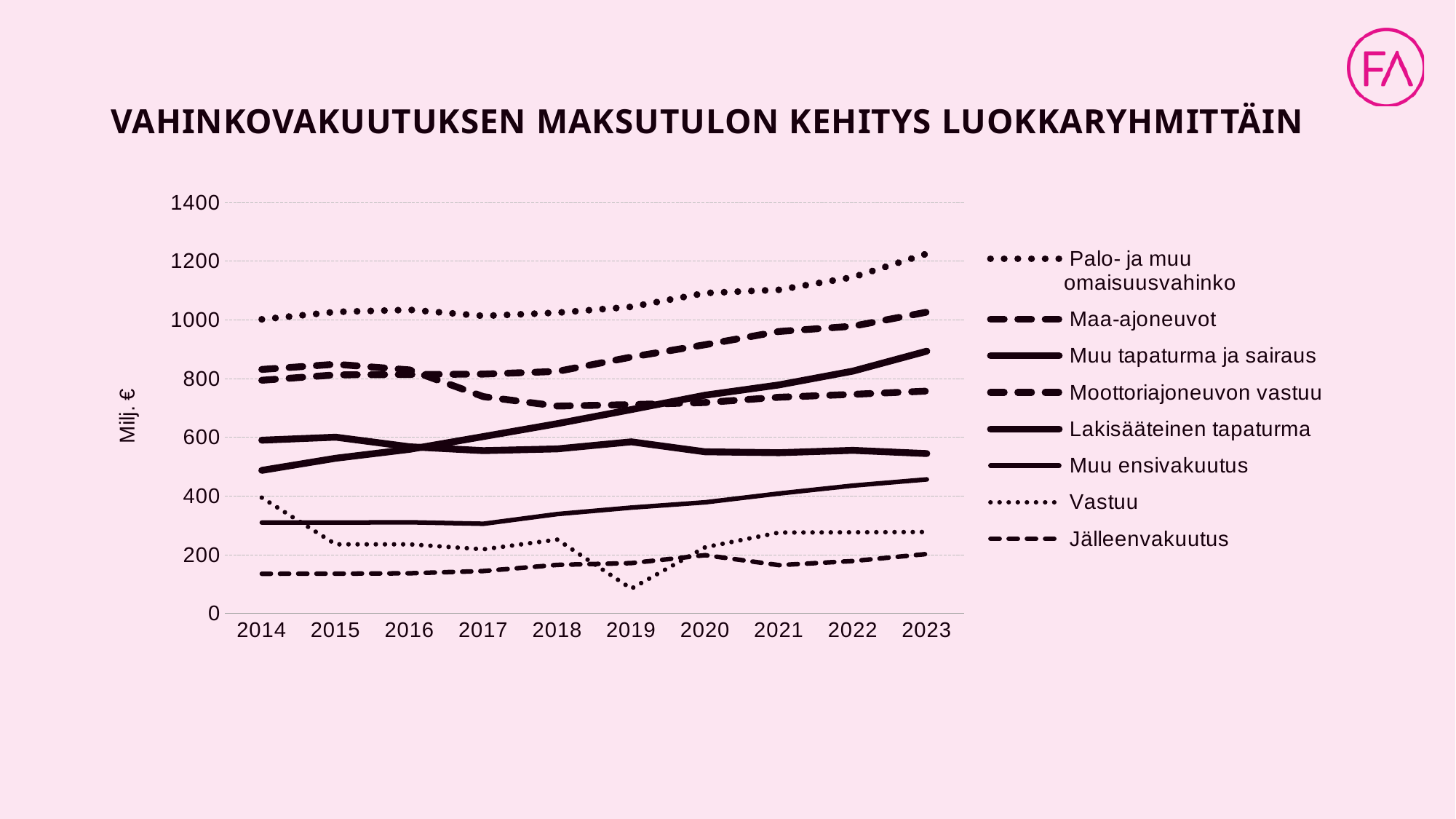
How many years are shown on the x axis? 10 Which series has the highest value in 2023? Palo- ja muu omaisuusvahinko Does the Muu ensivakuutus series rise or fall from 2014 to 2023? rise What is the label of the y axis? Milj. € Which series has the lowest value in 2023? Jälleenvakuutus In which year does the Vastuu series reach its lowest value? 2019 Is the value for Vastuu in 2019 greater or less than 200? less Which is larger in 2023, Maa-ajoneuvot or Muu tapaturma ja sairaus? Maa-ajoneuvot Is the value for Palo- ja muu omaisuusvahinko in 2023 greater or less than 1100? greater Is the value for Muu tapaturma ja sairaus in 2014 greater or less than 600? less How many series does the legend list? 8 What kind of chart is shown on the slide? line chart